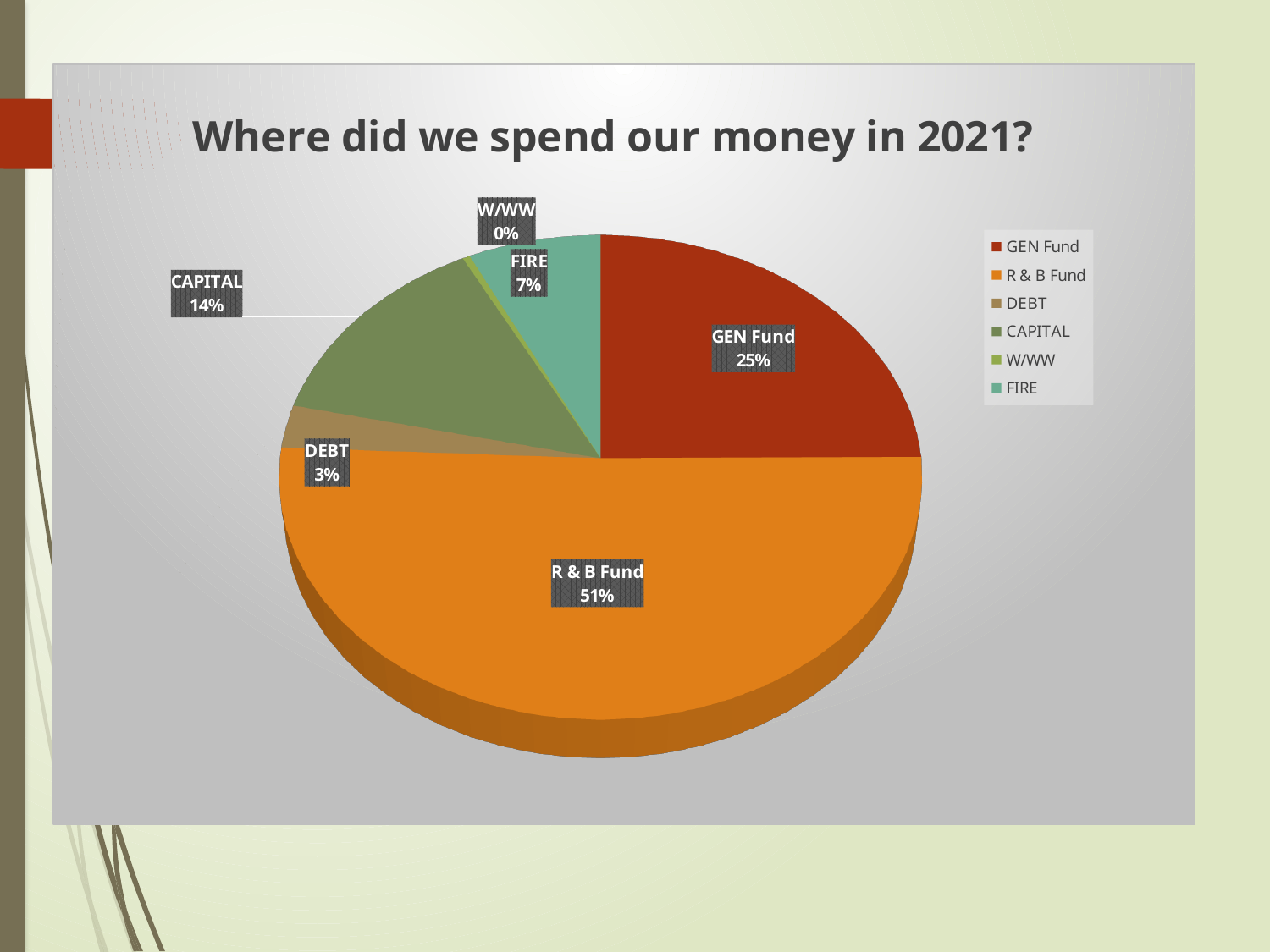
What percentage of the pie is the GEN Fund slice? 25% What share does CAPITAL represent? 14% Which is larger, the CAPITAL share or the FIRE share? CAPITAL How many percentage points larger is the R & B Fund share than the GEN Fund share? 26 What is the title of the slide? Where did we spend our money in 2021? What kind of chart is shown on the slide? Pie chart What percentage is shown for FIRE? 7% What percentage is shown for DEBT? 3% Which category has the smallest share of the pie? W/WW How many categories does the legend list? 6 What share of spending went to the R & B Fund? 51% Which category has the largest share of the pie? R & B Fund